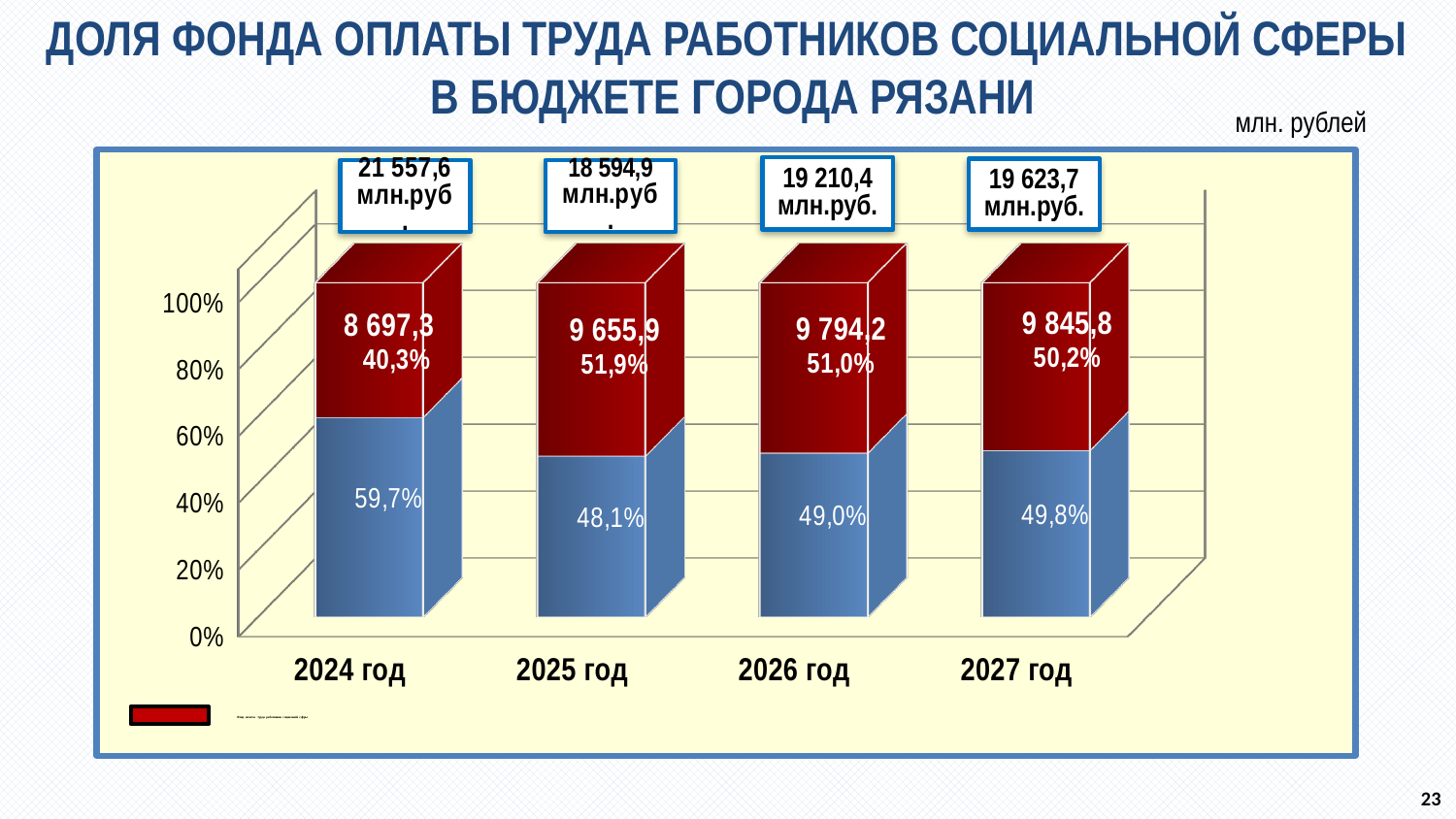
Do the red segment values rise or fall from 2024 год to 2027 год? Rise How many years are shown on the x axis? 4 Which year has the highest percentage on the red segment? 2025 год What is the value of the red segment for 2024 год? 8 697,3 What is the difference between the total amounts shown above the bars for 2024 год and 2025 год? 2 962,7 What percentage is shown on the red segment for 2025 год? 51,9% What is the difference between the red segment values for 2027 год and 2026 год? 51,6 Which year has the lowest percentage on the red segment? 2024 год What percentage is shown on the blue segment for 2026 год? 49,0% What total amount is shown in the box above the bar for 2027 год? 19 623,7 млн.руб. What kind of chart is shown on the slide? Stacked bar chart Which year has the larger blue segment percentage, 2024 год or 2025 год? 2024 год